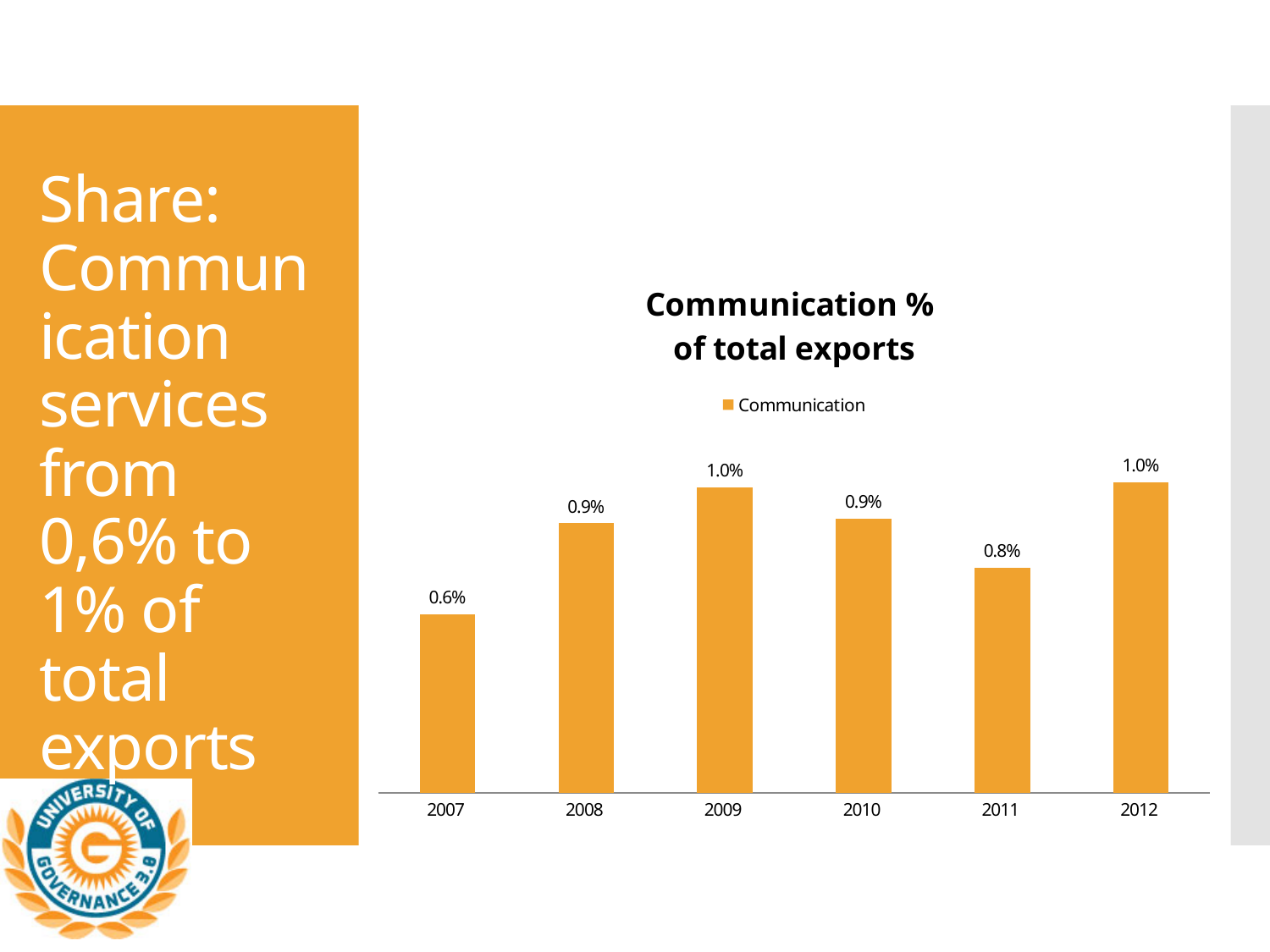
What is the value for 2007? 0.6% What kind of chart is shown? bar chart Do the values rise or fall from 2007 to 2009? rise What is the value for 2010? 0.9% What is the difference between the values for 2012 and 2007? 0.4% What is the value for 2009? 1.0% What is the difference between the values for 2009 and 2011? 0.2% What is the value for 2011? 0.8% Which is larger, the value for 2008 or the value for 2011? 2008 How many series does the legend list? 1 How many years are shown on the x axis? 6 Which year has the lowest value? 2007